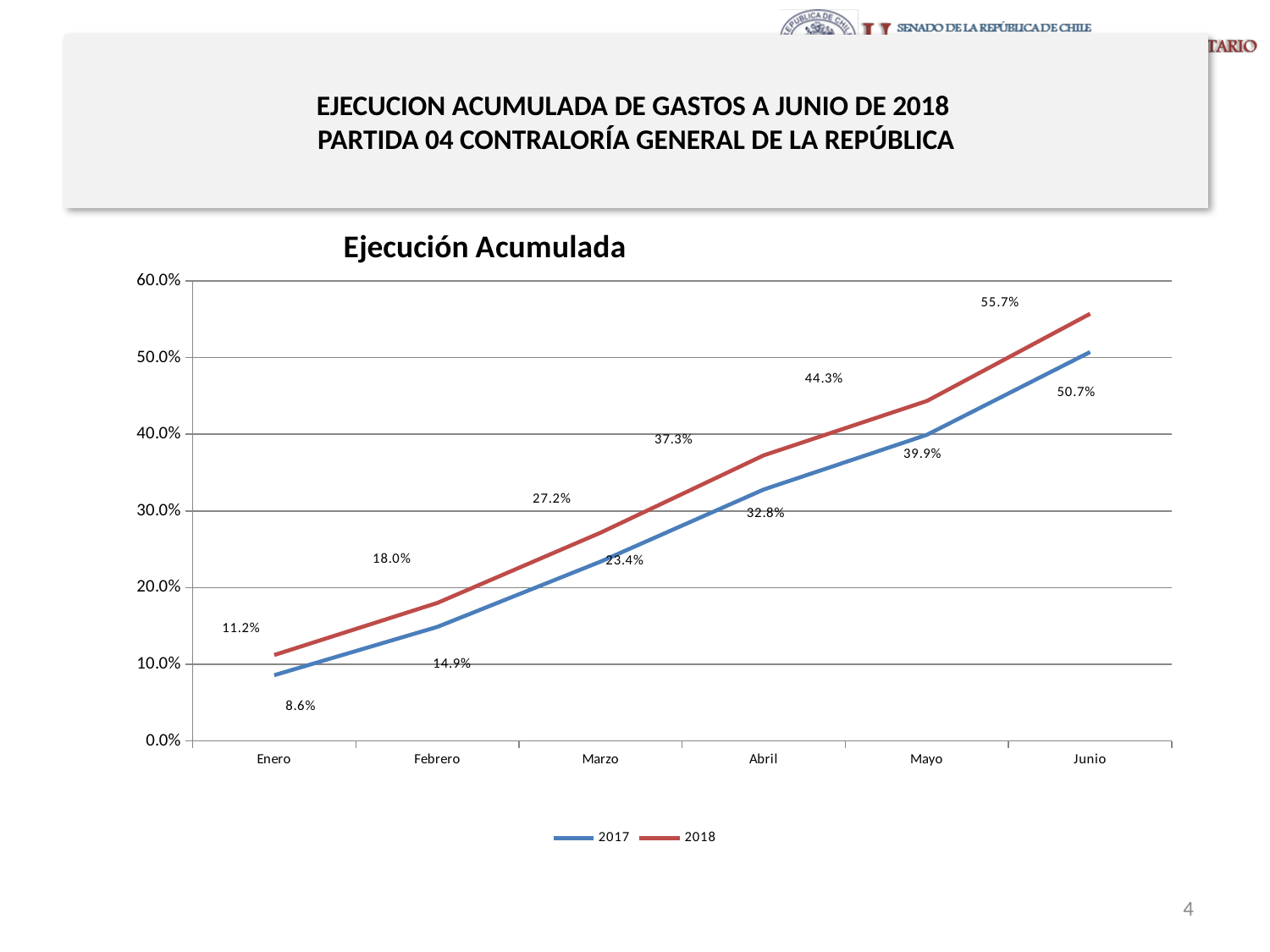
What is the value for 2017 in Mayo? 39.9% What is the difference between the 2018 and 2017 values in Abril? 4.5% What is the value for 2018 in Marzo? 27.2% In which month is the 2017 series lowest? Enero What is the value for 2018 in Junio? 55.7% Do the values of the 2017 series rise or fall from Enero to Junio? rise What is the value for 2017 in Enero? 8.6% How many series does the legend list? 2 What type of chart is shown on the slide? line chart Which series has the larger value in Febrero, 2017 or 2018? 2018 In which month is the 2018 series highest? Junio How many months are plotted on the x axis? 6